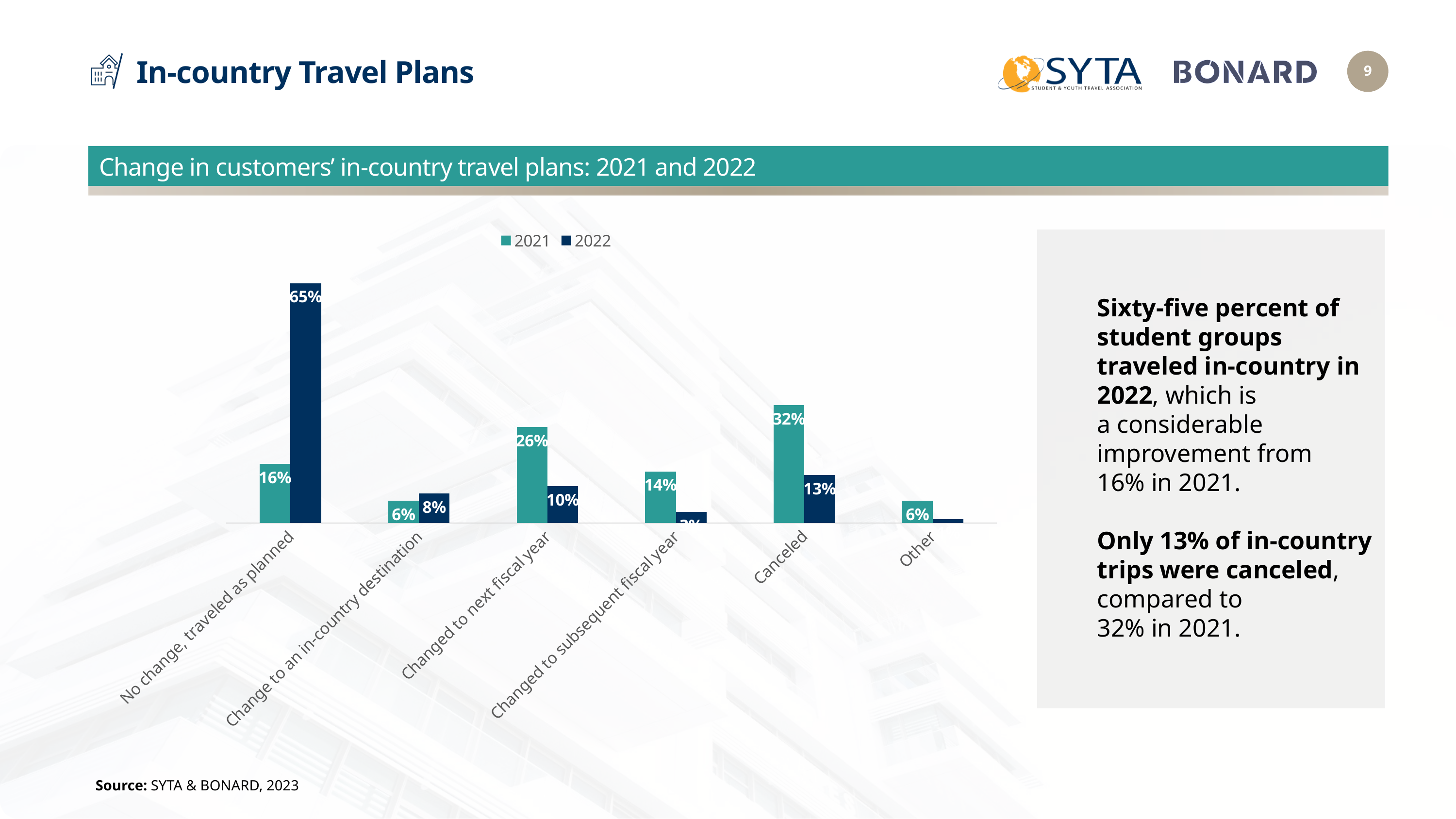
What is the difference between the 2021 and 2022 values for 'Canceled'? 19 percentage points What kind of chart is shown on the slide? Bar chart Which category has the highest 2021 value? Canceled Which category has the highest 2022 value? No change, traveled as planned How many series does the legend list? 2 How many categories are shown on the x axis? 6 What was the 2021 value for 'Changed to next fiscal year'? 26% What was the 2021 value for 'Canceled'? 32% What was the 2022 value for 'No change, traveled as planned'? 65% What is the difference between the 2022 and 2021 values for 'No change, traveled as planned'? 49 percentage points What was the 2022 value for 'Change to an in-country destination'? 8% Which is larger for 'Changed to next fiscal year': the 2021 value or the 2022 value? 2021